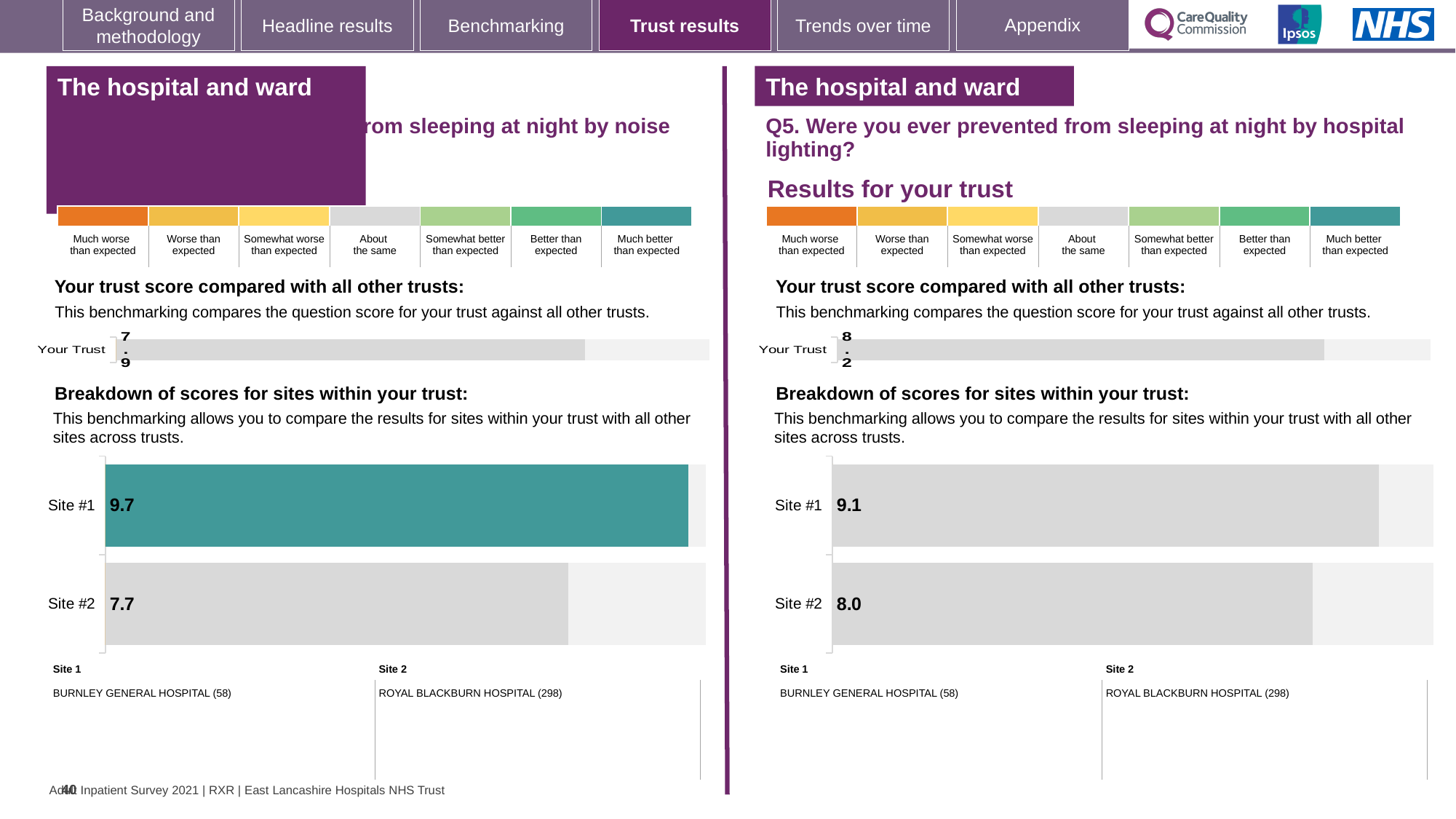
On the right-hand side of the slide (Q5, hospital lighting), what is the 'Your Trust' score shown in the trust comparison chart? 8.2 What type of chart is used for the breakdown of scores for sites within your trust? Bar chart On the right-hand side of the slide (Q5, hospital lighting), what is the difference between the Site #1 and Site #2 scores? 1.1 On the left-hand side of the slide, which site has the higher score in the site breakdown chart? Site #1 On the left-hand side of the slide, what is the 'Your Trust' score shown in the trust comparison chart? 7.9 On the right-hand side of the slide (Q5, hospital lighting), what is the score for Site #1? 9.1 On the right-hand side of the slide (Q5, hospital lighting), what is the score for Site #2? 8.0 On the left-hand side of the slide, what is the score for Site #2 in the breakdown of scores for sites within your trust? 7.7 On the right-hand side of the slide (Q5, hospital lighting), which site has the lower score in the site breakdown chart? Site #2 On the left-hand side of the slide, what is the score for Site #1 in the breakdown of scores for sites within your trust? 9.7 How many sites are shown in the site breakdown chart on the right-hand side of the slide? 2 On the left-hand side of the slide, what is the difference between the Site #1 and Site #2 scores? 2.0